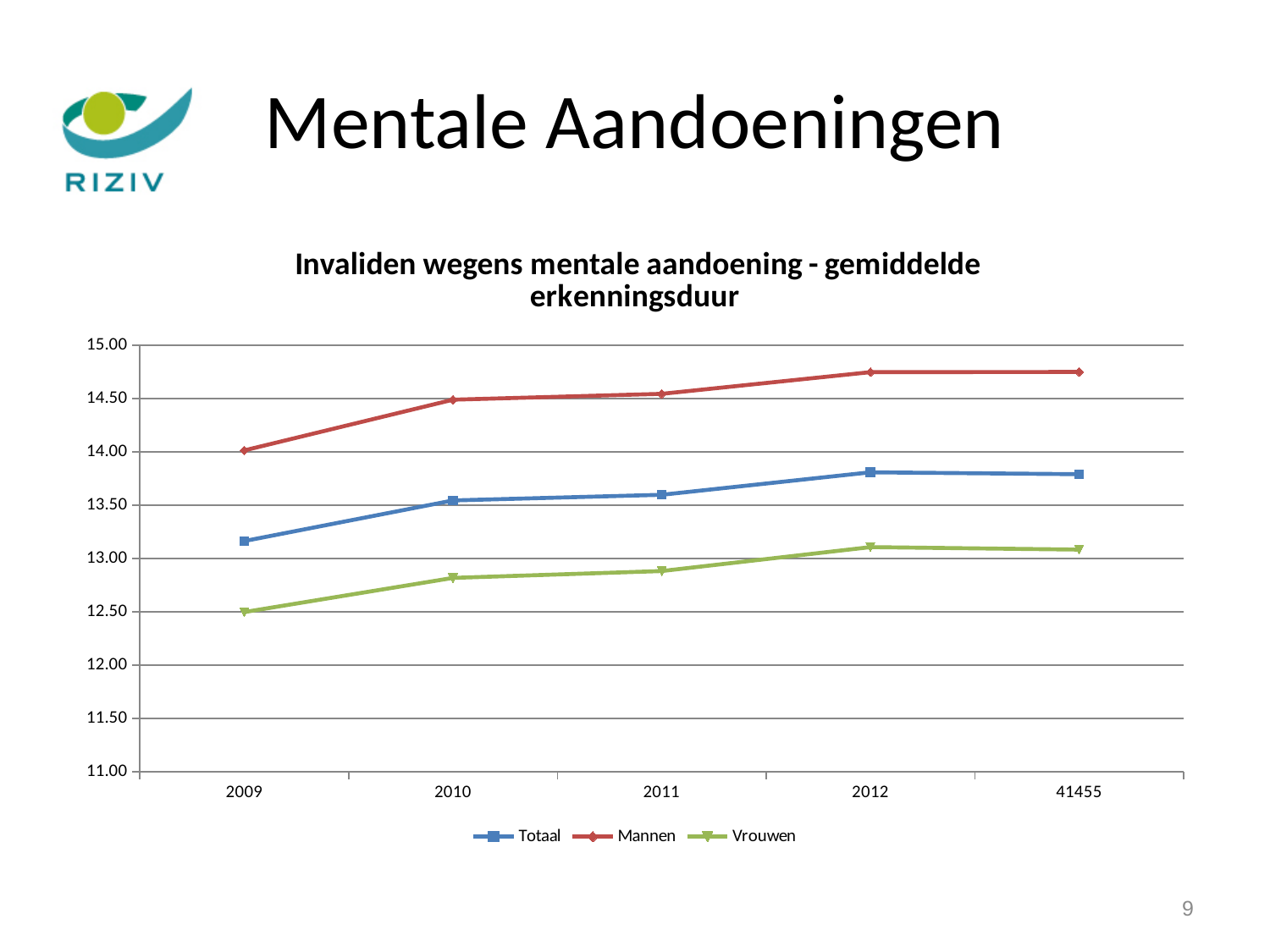
Which series has the highest values across all years? Mannen Which series has the lowest values across all years? Vrouwen What kind of chart is shown on the slide? line chart Is the value for Vrouwen in 2009 greater or less than 13.00? less What is the title of the chart? Invaliden wegens mentale aandoening - gemiddelde erkenningsduur Which is larger, the Totaal value in 2009 or the Totaal value in 2012? 2012 Is the value for Mannen in 2012 greater or less than 14.50? greater Is the value for Totaal in 2012 greater or less than 14.00? less Do the values for Mannen generally rise or fall from 2009 to 2012? rise How many points are plotted along the x axis for each series? 5 How many series does the legend list? 3